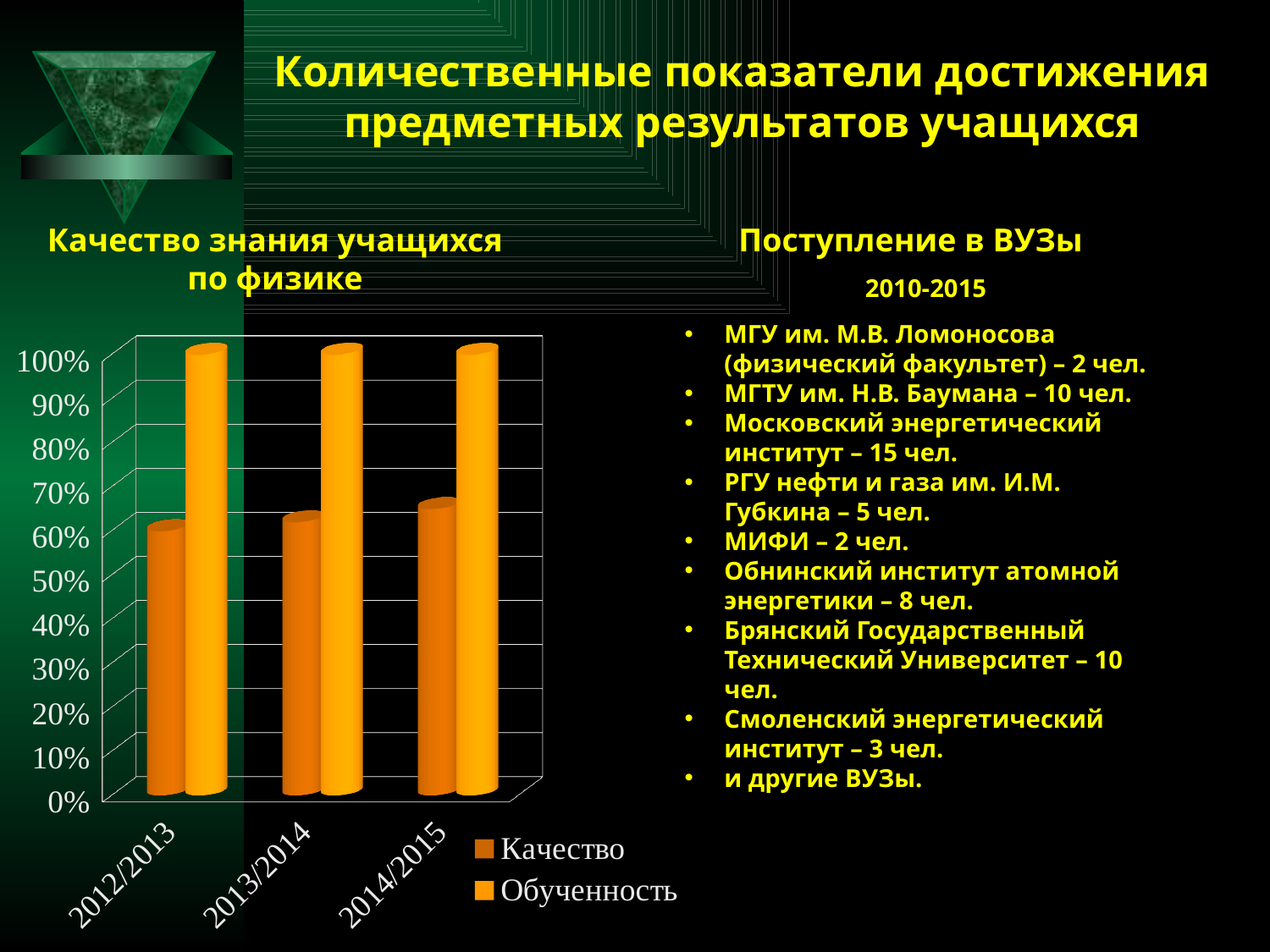
In 2013/2014, which series has the larger value, Качество or Обученность? Обученность Is the value for Качество in 2012/2013 greater or less than 70%? less Is the value for Качество in 2012/2013 greater or less than 50%? greater What are the two series named in the chart legend? Качество and Обученность How many school years (categories) are shown on the x axis of the chart? 3 Is the value for Качество in 2014/2015 greater or less than 80%? less Do the Качество values rise or fall from 2012/2013 to 2014/2015? rise What kind of chart is shown on the slide? bar chart How many series does the chart legend list? 2 Which school year has the highest value for Качество? 2014/2015 What is the title above the chart? Качество знания учащихся по физике